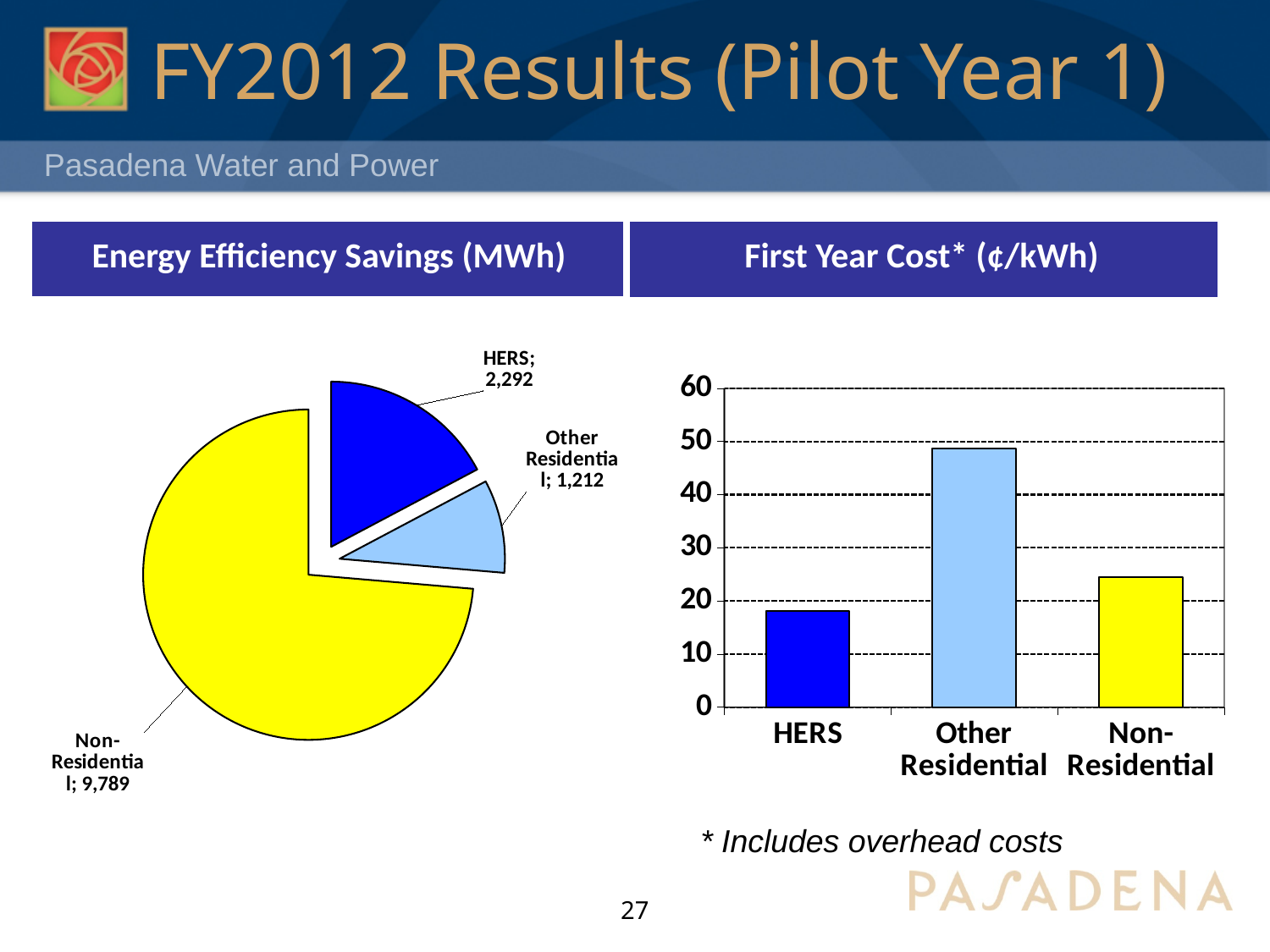
In the Energy Efficiency Savings (MWh) pie chart, what is the difference between the HERS and Other Residential values? 1,080 In the Energy Efficiency Savings (MWh) pie chart, what is the value for HERS? 2,292 In the First Year Cost* (¢/kWh) chart, is the value for HERS greater or less than 20? less In the Energy Efficiency Savings (MWh) pie chart, which category has the smallest slice? Other Residential What type of chart is the Energy Efficiency Savings (MWh) chart? Pie chart In the Energy Efficiency Savings (MWh) pie chart, what is the value for Non-Residential? 9,789 In the First Year Cost* (¢/kWh) chart, which category has the highest value? Other Residential In the Energy Efficiency Savings (MWh) pie chart, how many slices are there? 3 In the First Year Cost* (¢/kWh) chart, is the value for Other Residential greater or less than 40? greater In the Energy Efficiency Savings (MWh) pie chart, which category has the largest slice? Non-Residential In the Energy Efficiency Savings (MWh) pie chart, what is the value for Other Residential? 1,212 What type of chart is the First Year Cost* (¢/kWh) chart? Bar chart